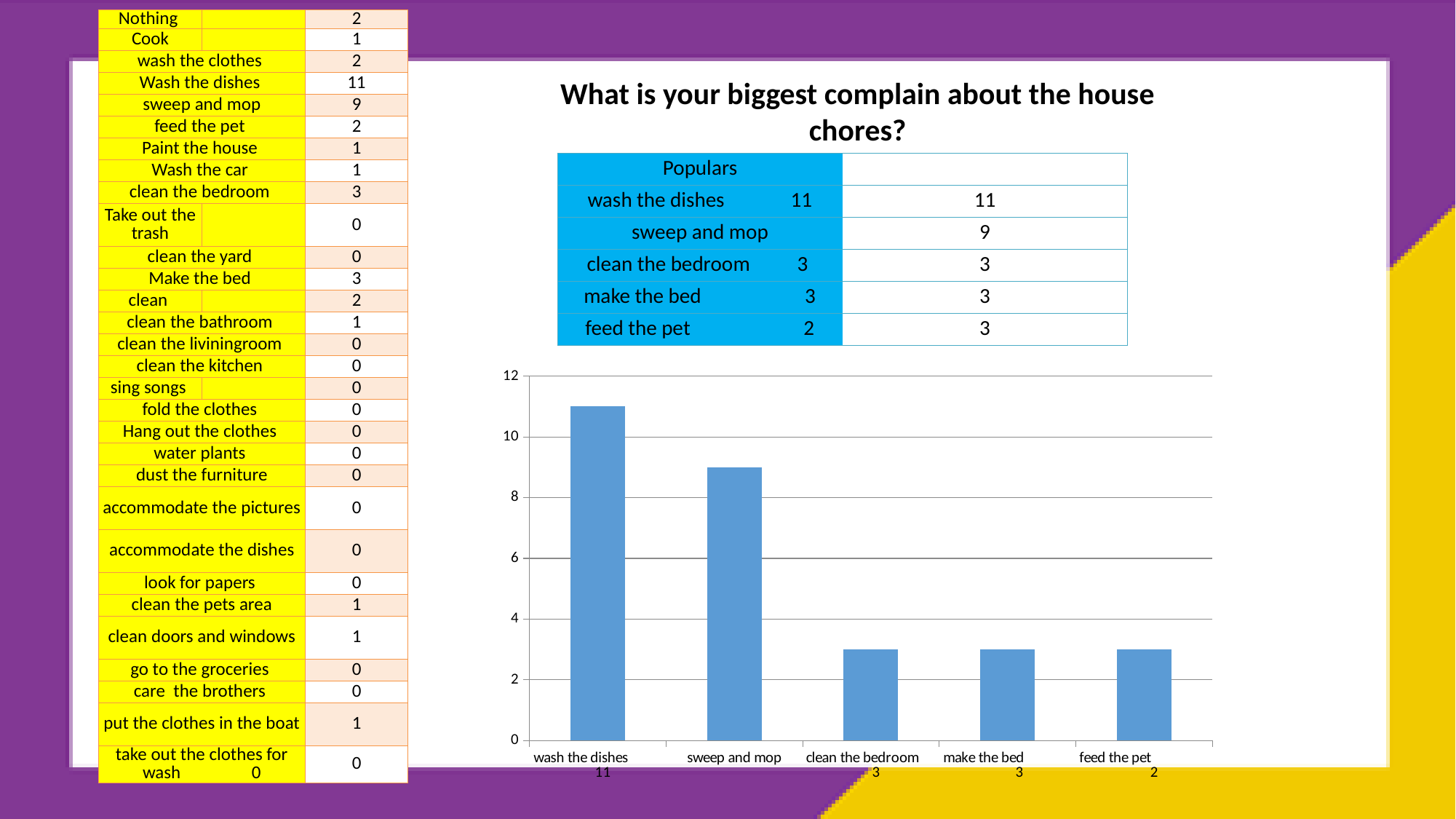
What is the value for make the bed? 3 Is the value for sweep and mop greater or less than 8? greater What is the difference between the values for wash the dishes and sweep and mop? 2 What is the value for sweep and mop? 9 Which is larger, the value for sweep and mop or the value for clean the bedroom? sweep and mop What is the value for clean the bedroom? 3 What is the title of the chart? What is your biggest complain about the house chores? Which category has the highest bar in the chart? wash the dishes How many categories are plotted on the x axis of the chart? 5 Do the bar values rise or fall from left to right along the x axis? fall What kind of chart is shown on the slide? bar chart What is the value for wash the dishes? 11